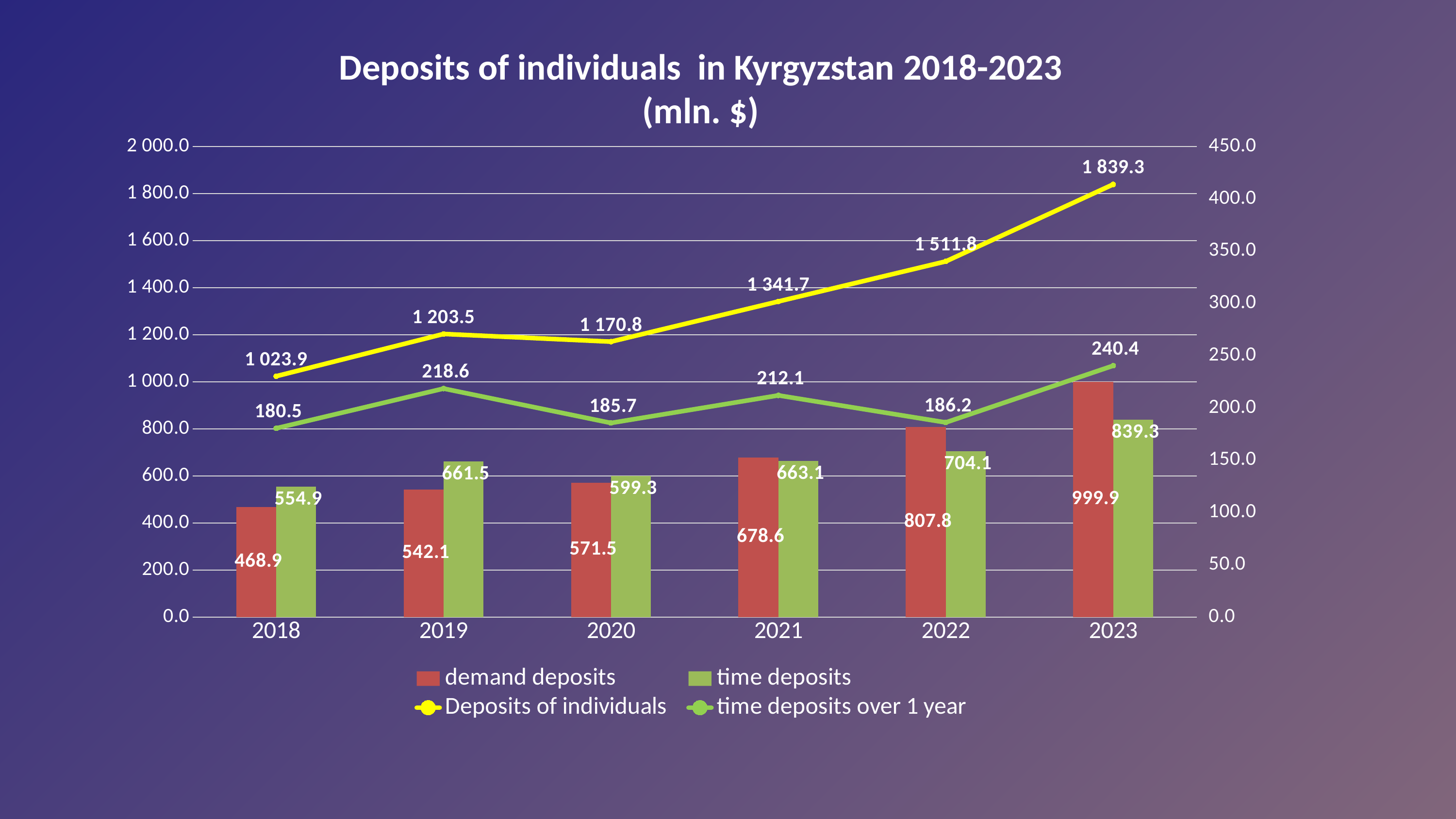
What is the value of time deposits over 1 year in 2019? 218.6 What is the value of Deposits of individuals in 2022? 1 511.8 Which is larger in 2019: demand deposits or time deposits? time deposits How many series does the legend list? 4 In which year are time deposits over 1 year lowest? 2018 In which year are demand deposits highest? 2023 Do demand deposits rise or fall from 2018 to 2023? rise By how much did Deposits of individuals increase from 2018 to 2023? 815.4 What is the value of demand deposits in 2021? 678.6 How many years are shown on the x axis? 6 What is the value of time deposits in 2020? 599.3 What is the difference between demand deposits and time deposits in 2023? 160.6